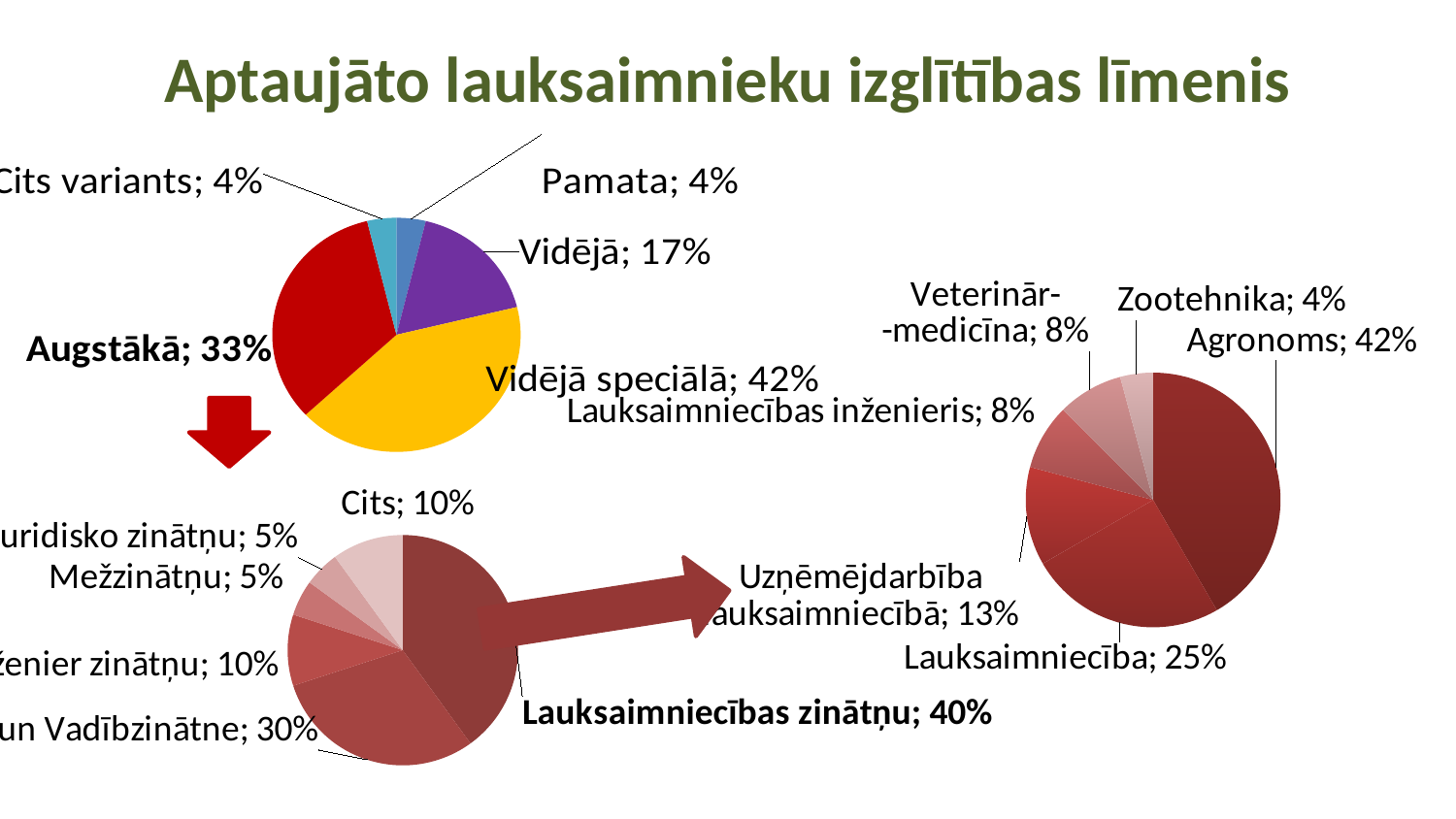
In the bottom-left pie chart, what share is labelled for Cits? 10% In the right-hand pie chart, which category has the smallest share? Zootehnika In the bottom-left pie chart, which category has the largest share? Lauksaimniecības zinātņu In the top-left pie chart, what is the difference between the shares for Vidējā speciālā and Augstākā? 9 percentage points In the top-left pie chart, which is larger: Vidējā or Augstākā? Augstākā In the right-hand pie chart, what share is labelled for Agronoms? 42% In the top-left pie chart, which category has the largest share? Vidējā speciālā How many slices does the top-left pie chart have? 5 In the top-left pie chart, what share is labelled for Vidējā speciālā? 42% In the right-hand pie chart, what is the difference between the shares for Agronoms and Lauksaimniecība? 17 percentage points In the bottom-left pie chart, what share is labelled for Lauksaimniecības zinātņu? 40% In the top-left pie chart, what share is labelled for Augstākā? 33%